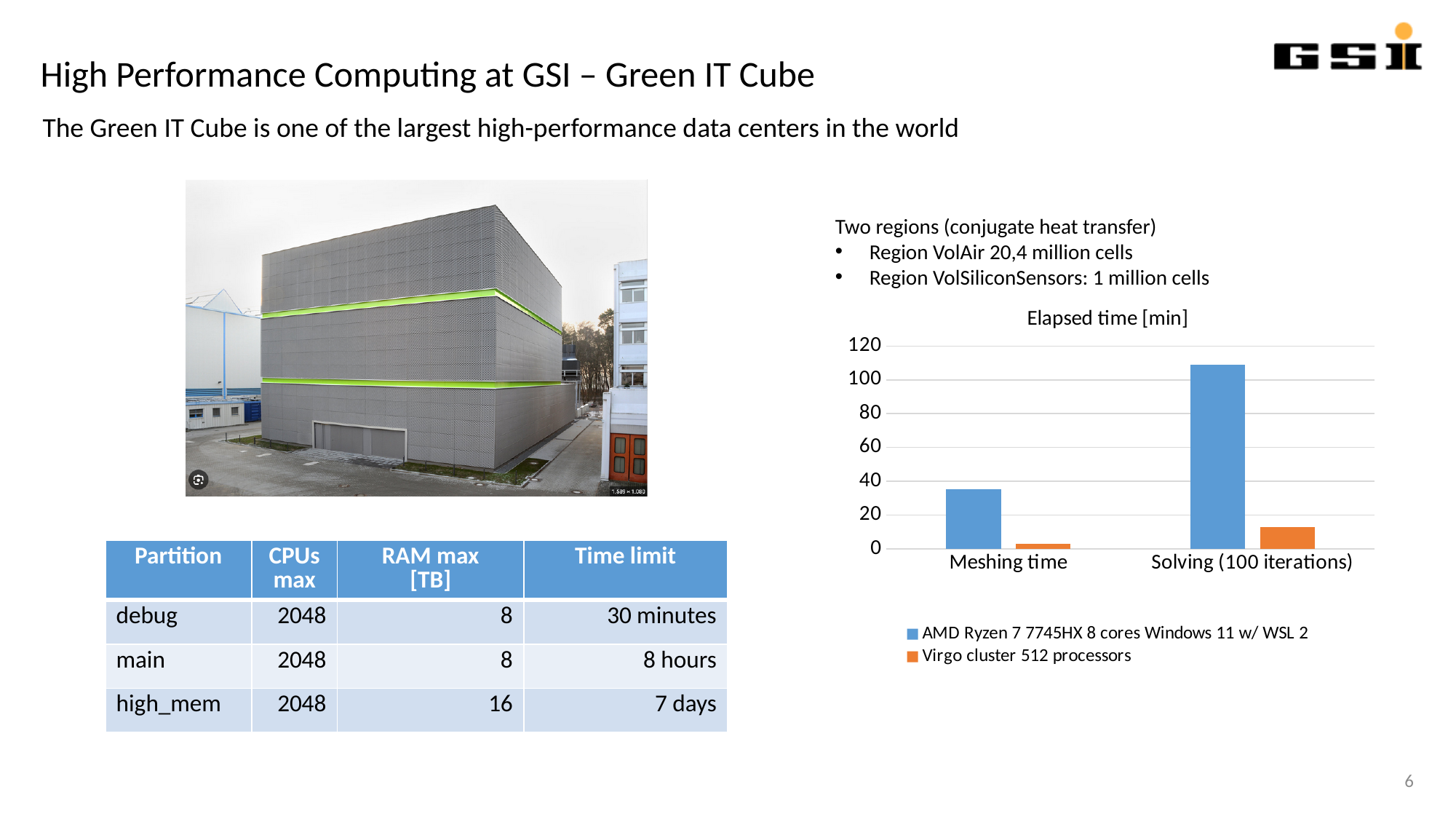
In the 'Elapsed time [min]' chart, which series has the lowest bar for Meshing time? Virgo cluster 512 processors What kind of chart is the 'Elapsed time [min]' chart? bar chart In the 'Elapsed time [min]' chart, which series has the larger value for Solving (100 iterations): AMD Ryzen 7 7745HX or Virgo cluster 512 processors? AMD Ryzen 7 7745HX 8 cores Windows 11 w/ WSL 2 In the 'Elapsed time [min]' chart, is the Virgo cluster 512 processors value for Solving (100 iterations) greater or less than 20? less How many categories are shown on the x axis of the 'Elapsed time [min]' chart? 2 In the 'Elapsed time [min]' chart, is the AMD Ryzen 7 7745HX value for Solving (100 iterations) greater or less than 100? greater How many series does the legend of the 'Elapsed time [min]' chart list? 2 What colour are the bars for the Virgo cluster 512 processors series in the 'Elapsed time [min]' chart? orange In the 'Elapsed time [min]' chart, is the Virgo cluster 512 processors value for Meshing time greater or less than 20? less In the 'Elapsed time [min]' chart, which category has the highest bar for the AMD Ryzen 7 7745HX series? Solving (100 iterations) In the 'Elapsed time [min]' chart, does the AMD Ryzen 7 7745HX series rise or fall from Meshing time to Solving (100 iterations)? rise